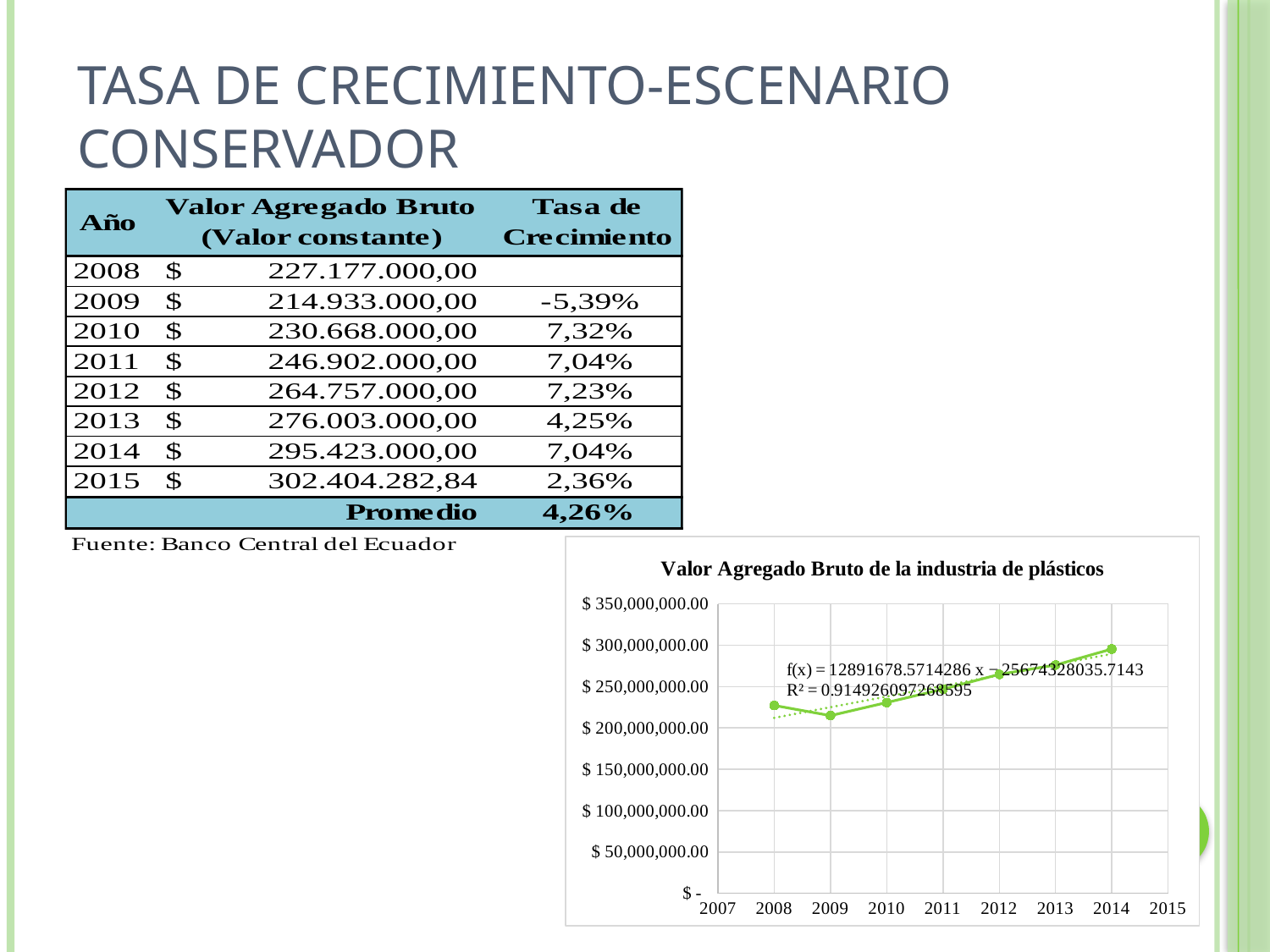
What R² value is printed on the chart for the trendline? R² = 0.914926097268595 Is the value for 2013 in the chart greater or less than $250,000,000.00? greater What kind of chart is shown on the slide? line chart In the chart, which year has the larger value, 2010 or 2012? 2012 What is the title of the chart? Valor Agregado Bruto de la industria de plásticos Which year has the lowest value in the chart? 2009 Do the values in the chart generally rise or fall from 2009 to 2014? rise Which year has the highest value in the chart? 2014 How many data points are plotted on the line in the chart? 7 Is the value for 2009 in the chart greater or less than $250,000,000.00? less Is the value for 2008 in the chart greater or less than $200,000,000.00? greater